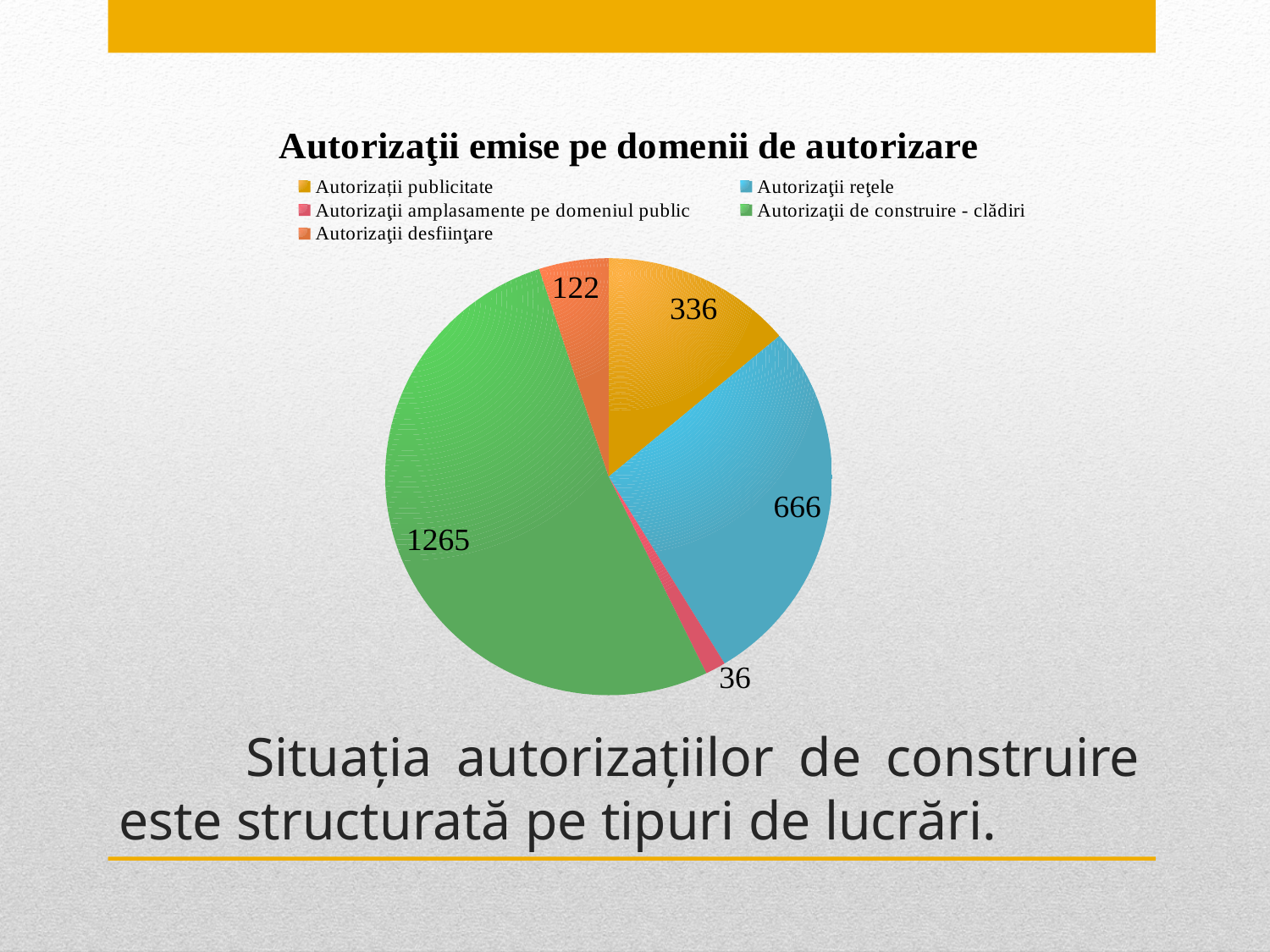
What type of chart is shown on the slide? pie chart What is the difference between the values for Autorizaţii reţele and Autorizaţii publicitate? 330 What is the value for Autorizaţii desfiinţare? 122 What is the value for Autorizaţii reţele? 666 Which category has the largest slice? Autorizaţii de construire - clădiri What is the title of the chart? Autorizaţii emise pe domenii de autorizare What is the value for Autorizaţii de construire - clădiri? 1265 Which is larger, Autorizaţii desfiinţare or Autorizaţii publicitate? Autorizaţii publicitate What is the value for Autorizaţii publicitate? 336 Which category has the smallest slice? Autorizaţii amplasamente pe domeniul public What is the value for Autorizaţii amplasamente pe domeniul public? 36 How many categories does the legend list? 5